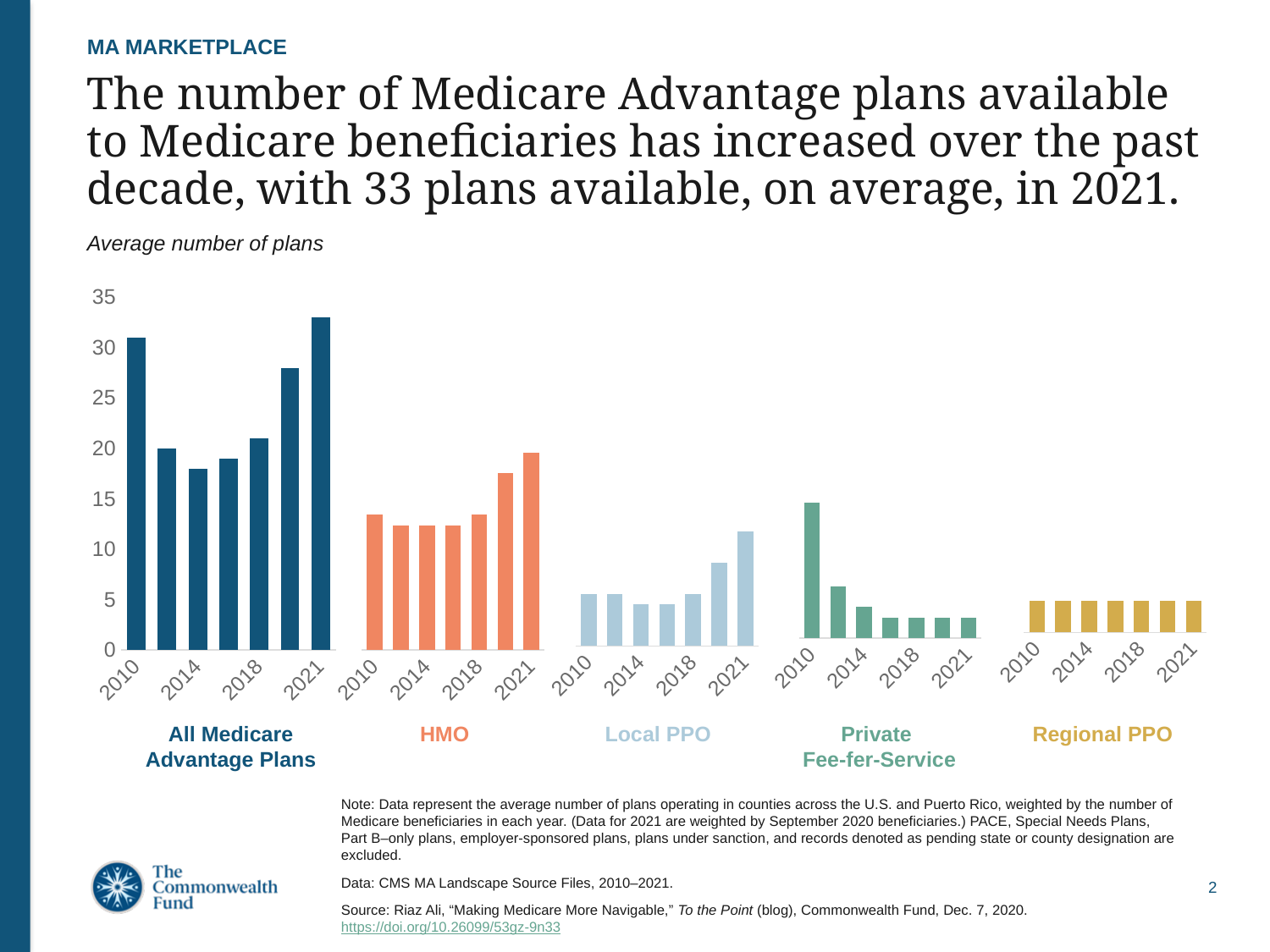
What kind of chart is shown on the slide? Bar chart Is the value for Private Fee-for-Service in 2010 greater or less than 10? greater Among the four individual plan types (HMO, Local PPO, Private Fee-for-Service, Regional PPO), which has the highest value in 2021? HMO Is the value for HMO in 2021 greater or less than 15? greater Is the value for Regional PPO in 2021 greater or less than 10? less Which group has the tallest bar for 2021? All Medicare Advantage Plans Among the four individual plan types, which has the lowest value in 2021? Private Fee-for-Service How many plan-type groups are shown in the chart? 5 Do the values for Private Fee-for-Service rise or fall from 2010 to 2021? fall According to the slide, what was the average number of Medicare Advantage plans available in 2021 (All Medicare Advantage Plans)? 33 Which is larger in 2021: the value for HMO or the value for Local PPO? HMO